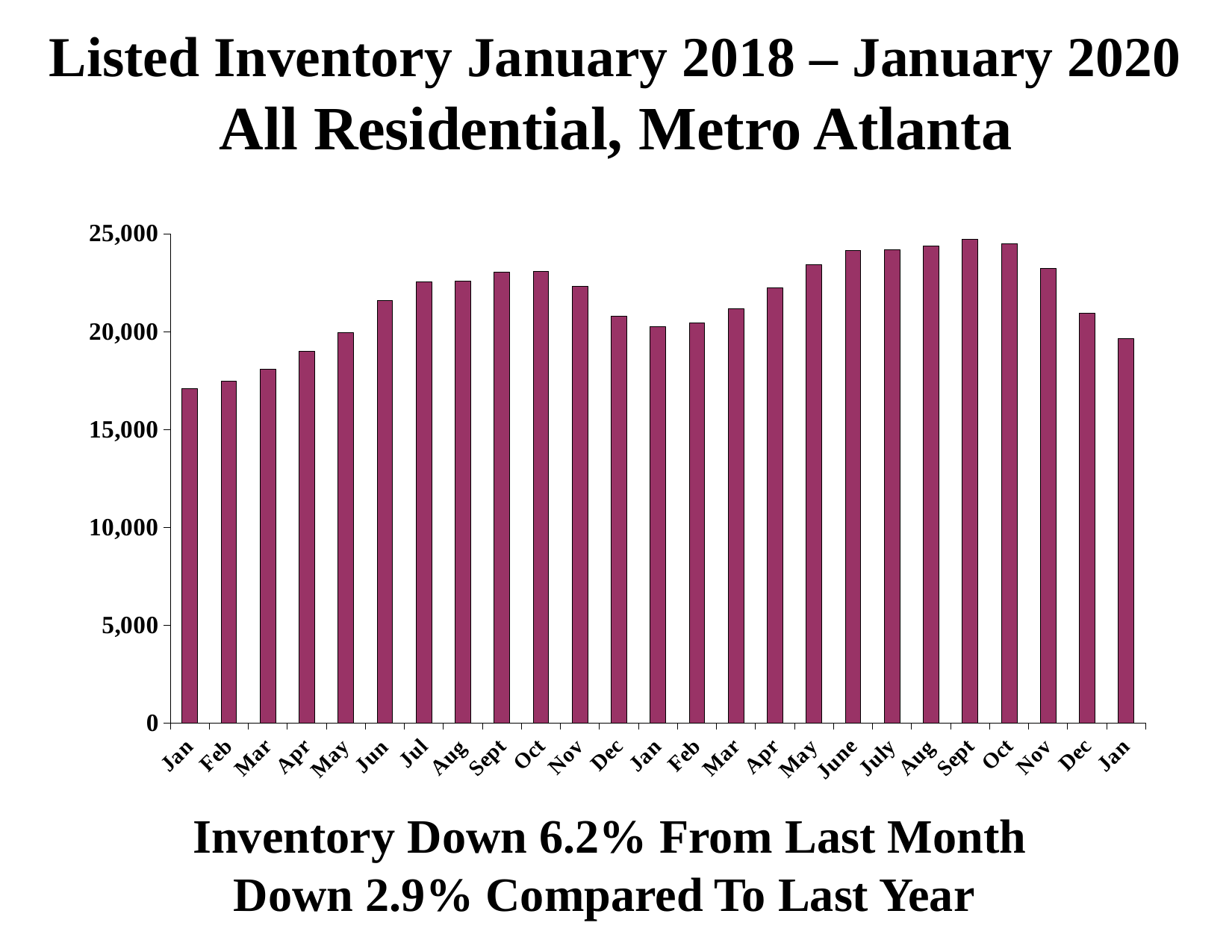
What kind of chart is shown on the slide? bar chart How many bars (months) are plotted in the chart? 25 Is the value for the second Sept bar (September 2019) greater or less than 20,000? greater Which month has the lowest listed inventory in the chart? Jan (2018, the first bar) Is the value for the first Jan bar (January 2018) greater or less than 20,000? less Is the value for the first Mar bar (March 2018) greater or less than 20,000? less What is the title of the chart on the slide? Listed Inventory January 2018 – January 2020 All Residential, Metro Atlanta Do the values rise or fall from the first Jan bar through the first Oct bar (January to October 2018)? rise Which is larger, the first Jan bar (January 2018) or the last Jan bar (January 2020)? Jan 2020 (the last bar) Which is larger, the first Sept bar (2018) or the second Sept bar (2019)? Sept 2019 (the second Sept bar)